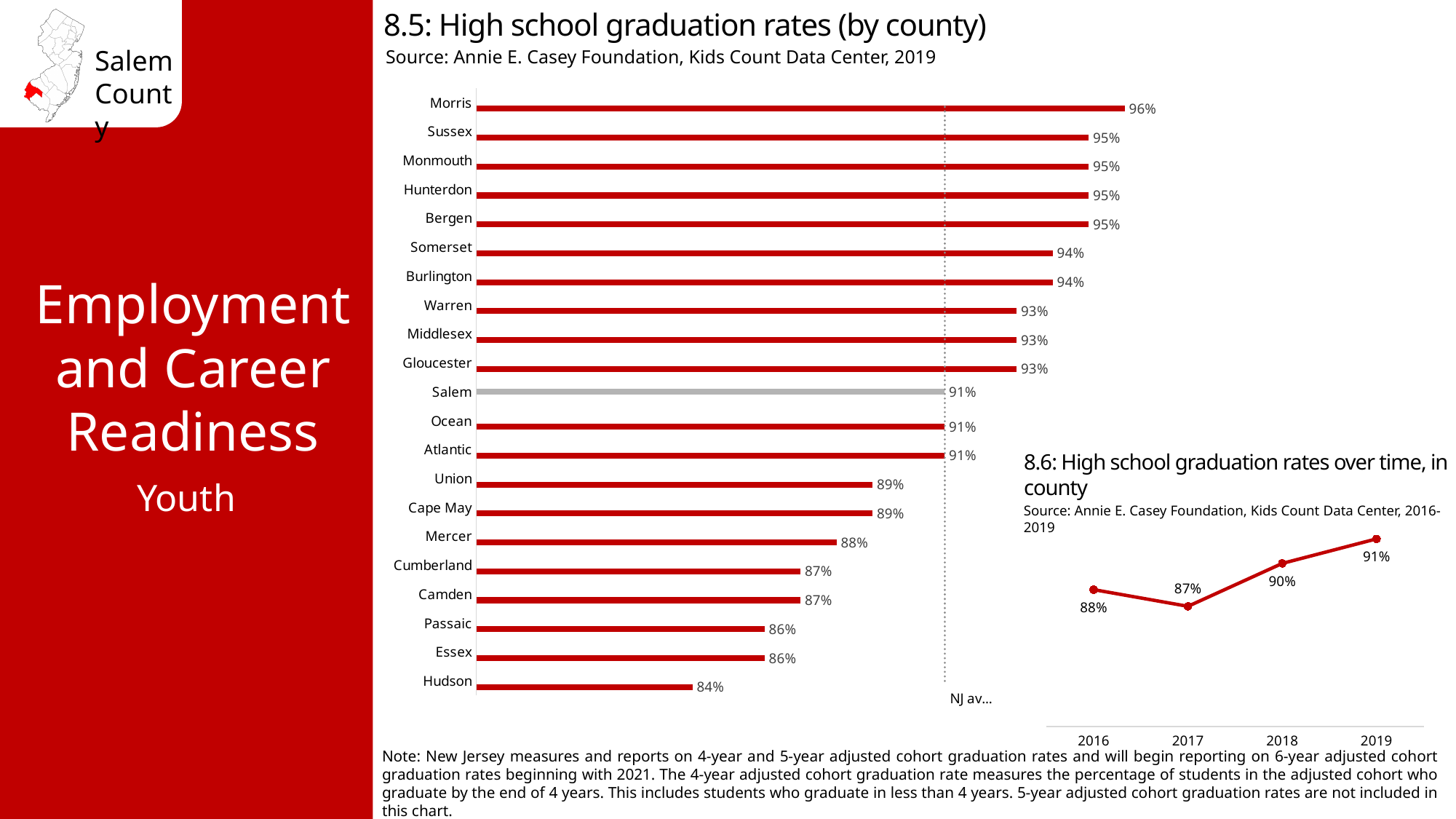
In the chart '8.5: High school graduation rates (by county)', which county has the highest graduation rate? Morris In the chart '8.5: High school graduation rates (by county)', what is the difference between the graduation rates of Morris and Hudson? 12 percentage points In the chart '8.5: High school graduation rates (by county)', which county has the lowest graduation rate? Hudson How many counties are shown in the chart '8.5: High school graduation rates (by county)'? 21 In the chart '8.5: High school graduation rates (by county)', which has a higher graduation rate, Mercer or Passaic? Mercer In the chart '8.5: High school graduation rates (by county)', what is the graduation rate for Cumberland? 87% What kind of chart is '8.5: High school graduation rates (by county)'? Bar chart In the chart '8.6: High school graduation rates over time, in county', what is the graduation rate for 2017? 87% In the chart '8.5: High school graduation rates (by county)', what is the graduation rate for Salem? 91% What kind of chart is '8.6: High school graduation rates over time, in county'? Line chart In the chart '8.6: High school graduation rates over time, in county', which year has the highest graduation rate? 2019 In the chart '8.6: High school graduation rates over time, in county', what is the difference between the 2019 and 2016 graduation rates? 3 percentage points